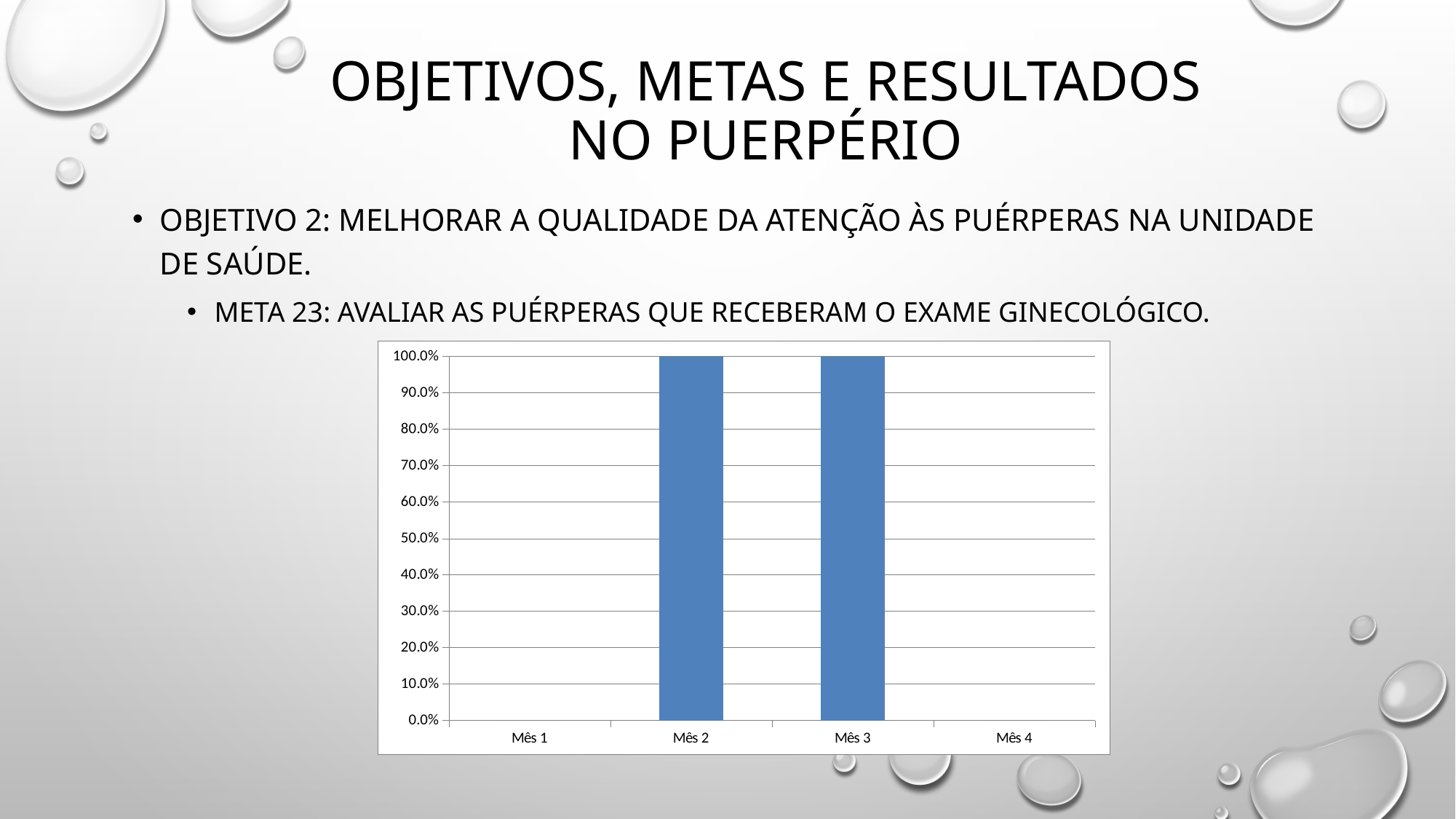
What is the difference between the values for Mês 2 and Mês 1 in the chart? 100.0% Which is larger in the chart, the value for Mês 2 or the value for Mês 4? Mês 2 What is the value for Mês 1 in the chart? 0.0% What is the value for Mês 3 in the chart? 100.0% What is the value for Mês 4 in the chart? 0.0% Is the value for Mês 3 greater or less than 50.0%? greater How many categories are shown on the x axis of the chart? 4 Is the value for Mês 1 greater or less than 10.0%? less What is the highest value shown on the y axis of the chart? 100.0% What kind of chart is shown on the slide? bar chart What is the value for Mês 2 in the chart? 100.0% What is the label of the first category on the x axis of the chart? Mês 1